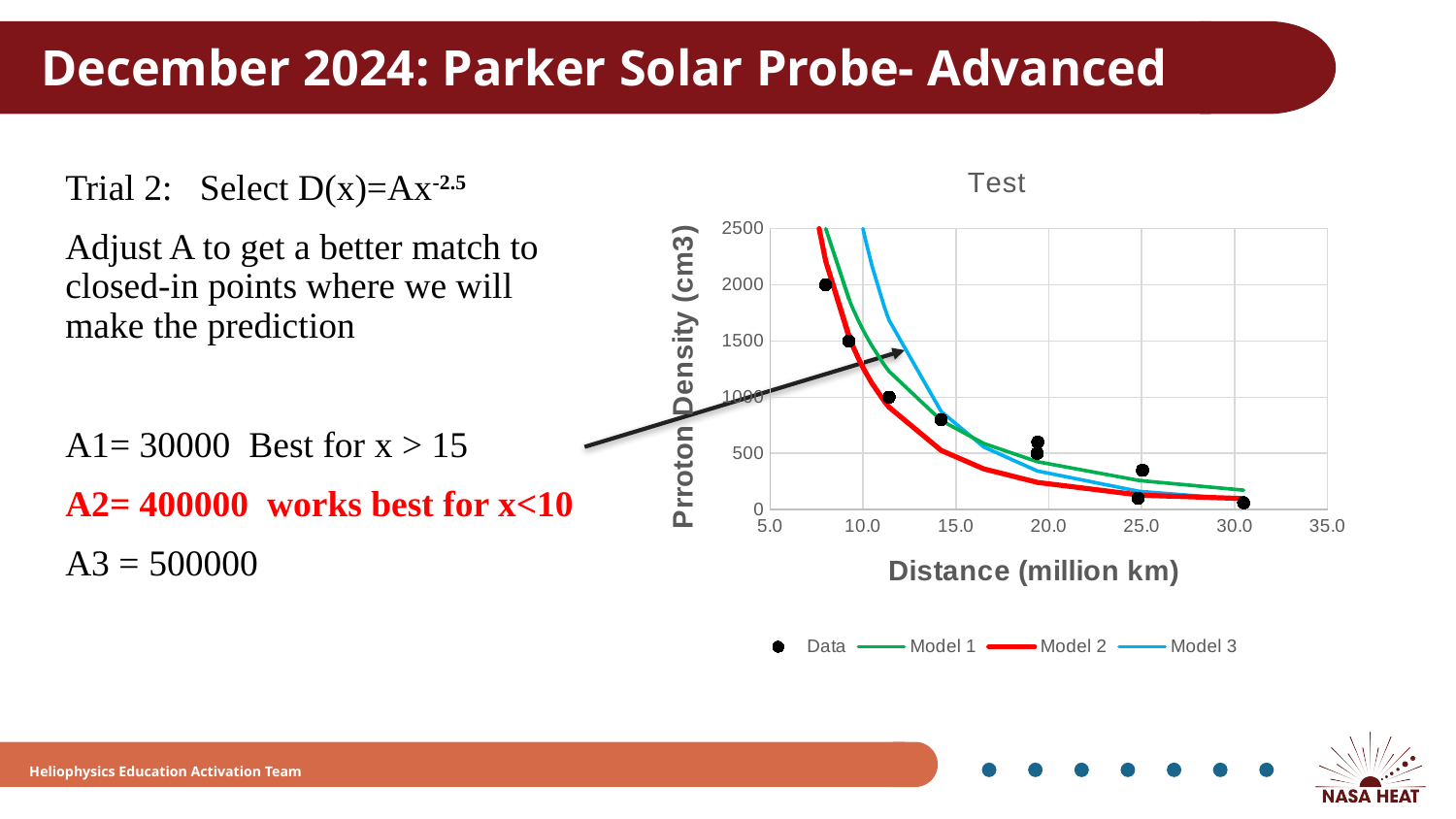
Is the Data value at a distance of about 30 million km greater or less than 500? less Do the Data values rise or fall as distance increases along the x axis? fall Is the Model 1 value at a distance of 30.0 million km greater or less than 500? less What kind of chart is shown on the slide? scatter chart At a distance of 10.0 million km, which is larger, Model 3 or Model 2? Model 3 What is the title of the chart? Test What is the label of the x axis of the chart? Distance (million km) Is the Model 2 value at a distance of 15.0 million km greater or less than 1000? less How many series does the chart legend list? 4 At a distance of 30.0 million km, which model line has the highest value? Model 1